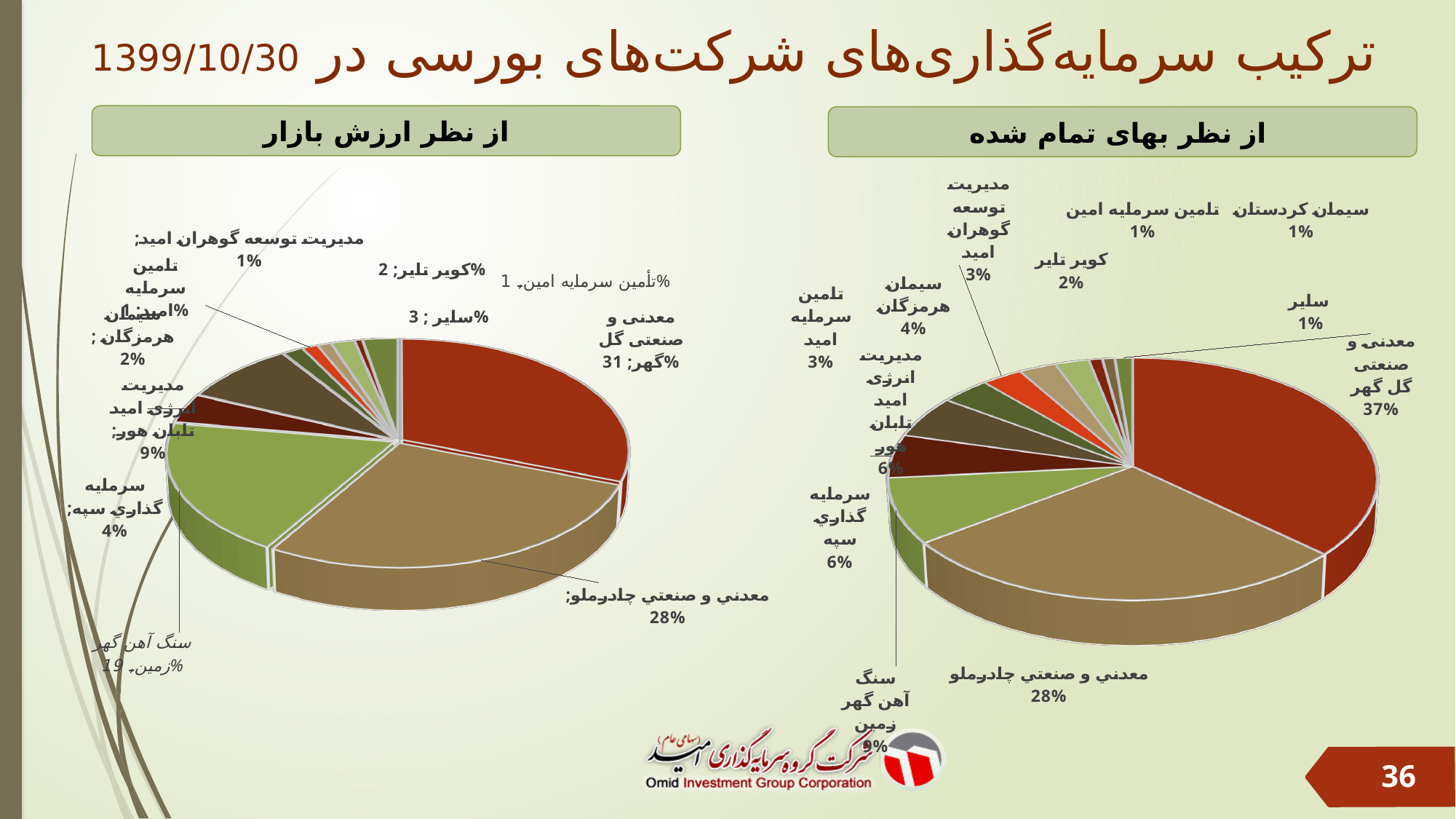
In the right chart (از نظر بهای تمام شده), what is the share of سنگ آهن گهر زمین? 9% What type of chart is used on this slide? pie chart In the left chart (از نظر ارزش بازار), what is the share of سنگ آهن گهر زمین? 19% In the right chart (از نظر بهای تمام شده), what share does معدنی و صنعتی گل گهر hold? 37% In the right chart (از نظر بهای تمام شده), what is the share of سیمان هرمزگان? 4% In the left chart (از نظر ارزش بازار), what is the share of مدیریت انرژی امید تابان هور? 9% In the right chart (از نظر بهای تمام شده), what is the difference between the shares of معدنی و صنعتی گل گهر and معدنی و صنعتی چادرملو? 9% In the left chart (از نظر ارزش بازار), what is the difference between the shares of معدنی و صنعتی گل گهر and معدنی و صنعتی چادرملو? 3% What is the title of the chart on the right side of the slide? از نظر بهای تمام شده In the left chart (از نظر ارزش بازار), what share does معدنی و صنعتی گل گهر hold? 31% In the right chart (از نظر بهای تمام شده), which company has the largest slice? معدنی و صنعتی گل گهر Which chart gives سرمایه گذاری سپه a larger share, the left (از نظر ارزش بازار) or the right (از نظر بهای تمام شده)? the right (از نظر بهای تمام شده)